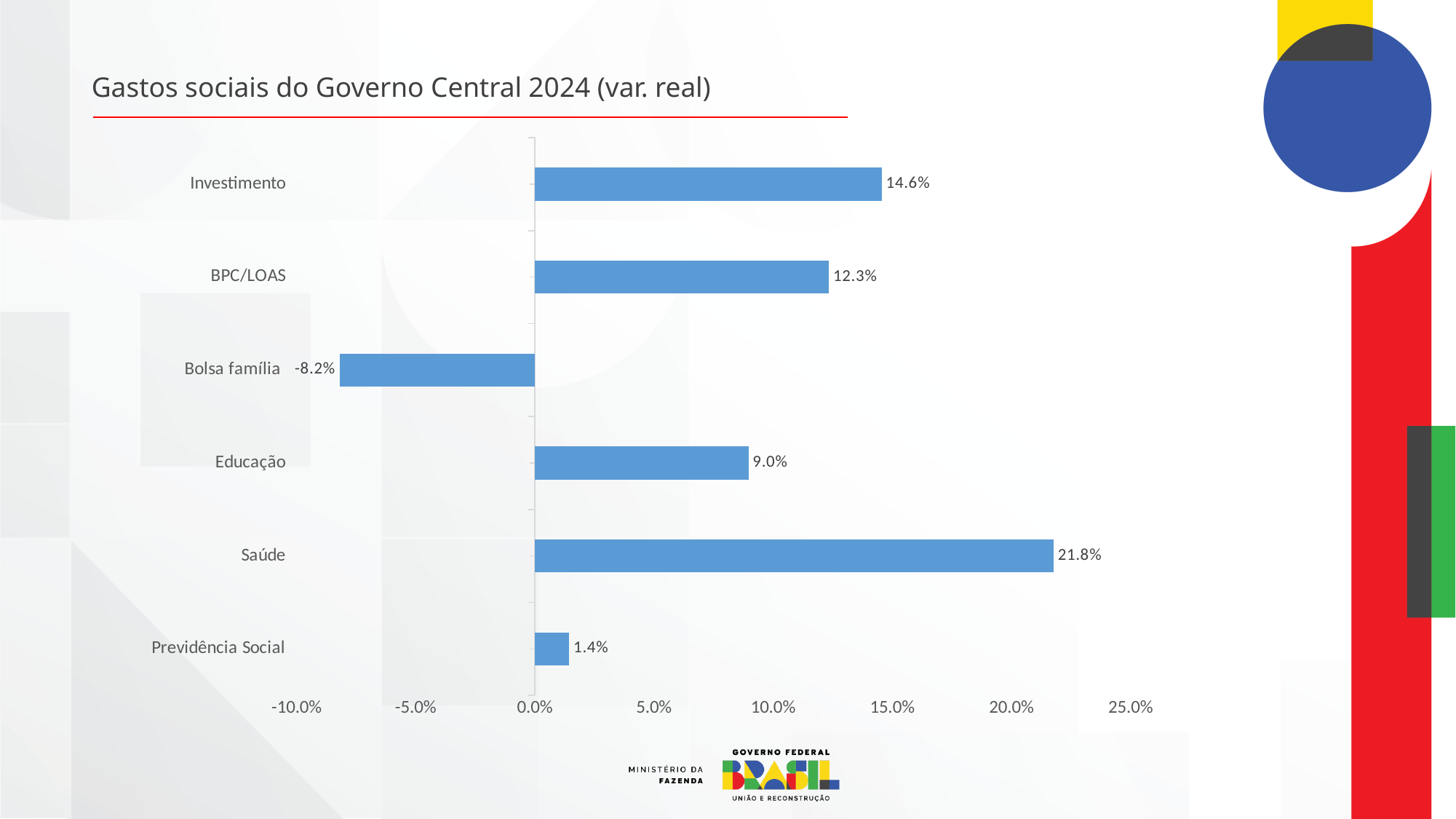
What is the value for Bolsa família? -8.2% How many categories have a negative value? 1 Is the value for Saúde greater or less than 20.0%? greater What kind of chart is shown on the slide? Bar chart What is the value for Previdência Social? 1.4% Which category has the lowest value? Bolsa família What is the value for Investimento? 14.6% Which category has the highest value? Saúde How many categories are shown in the chart? 6 What is the title of the chart? Gastos sociais do Governo Central 2024 (var. real) What is the difference between the values for Saúde and Investimento? 7.2% Which is larger, the value for BPC/LOAS or the value for Educação? BPC/LOAS